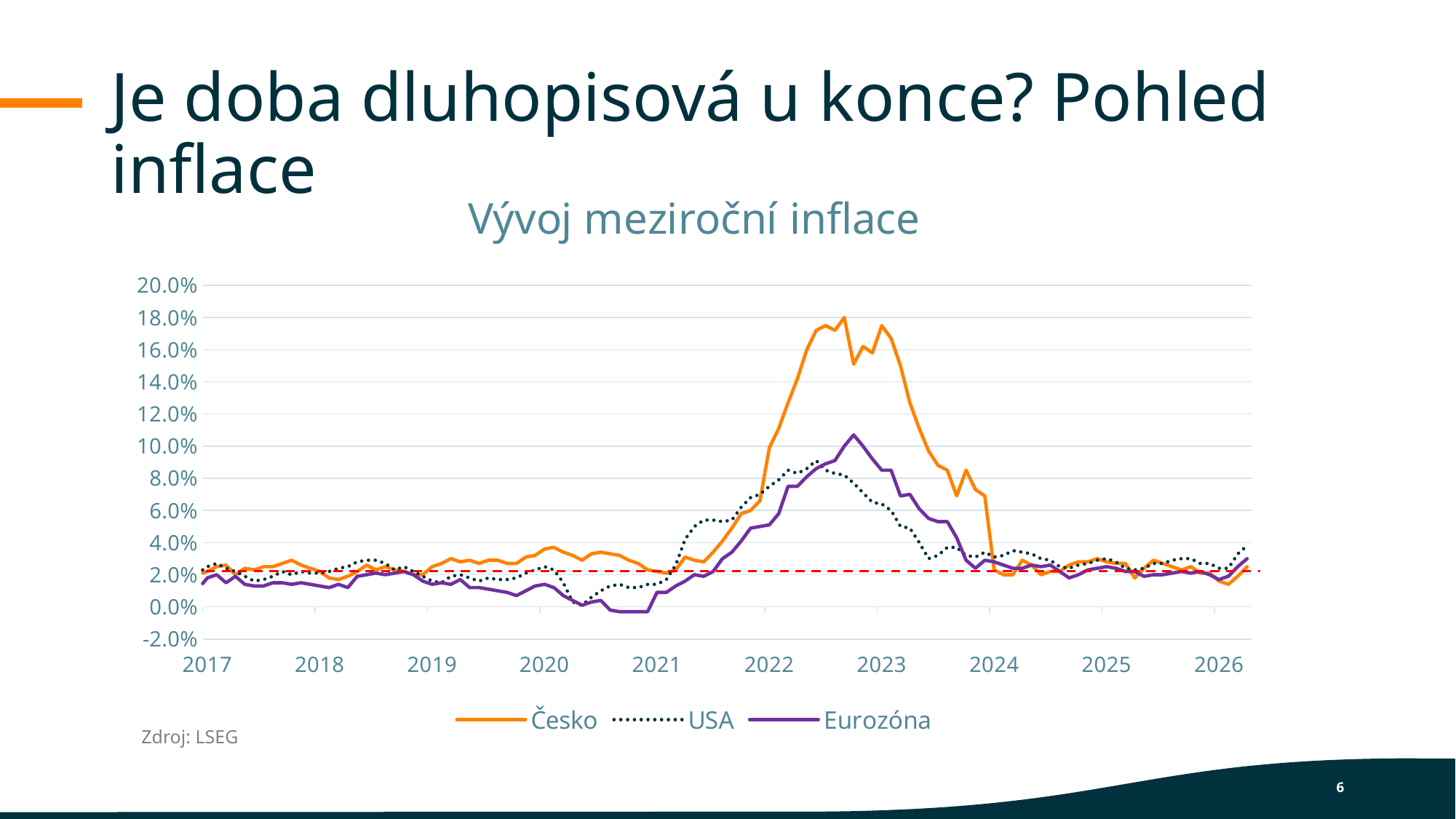
What kind of chart is shown on the slide? line chart What is the title of the chart? Vývoj meziroční inflace How many series does the legend of the chart list? 3 Does the Česko line rise or fall between 2023 and 2024? fall Is the peak value of Česko greater or less than 16.0%? greater Is the value for Česko at the start of 2023 greater or less than 14.0%? greater Is the peak value of USA greater or less than 10.0%? less Which series reaches the highest peak on the chart? Česko Which series falls to the lowest value on the chart? Eurozóna Which series is drawn with a dotted line? USA